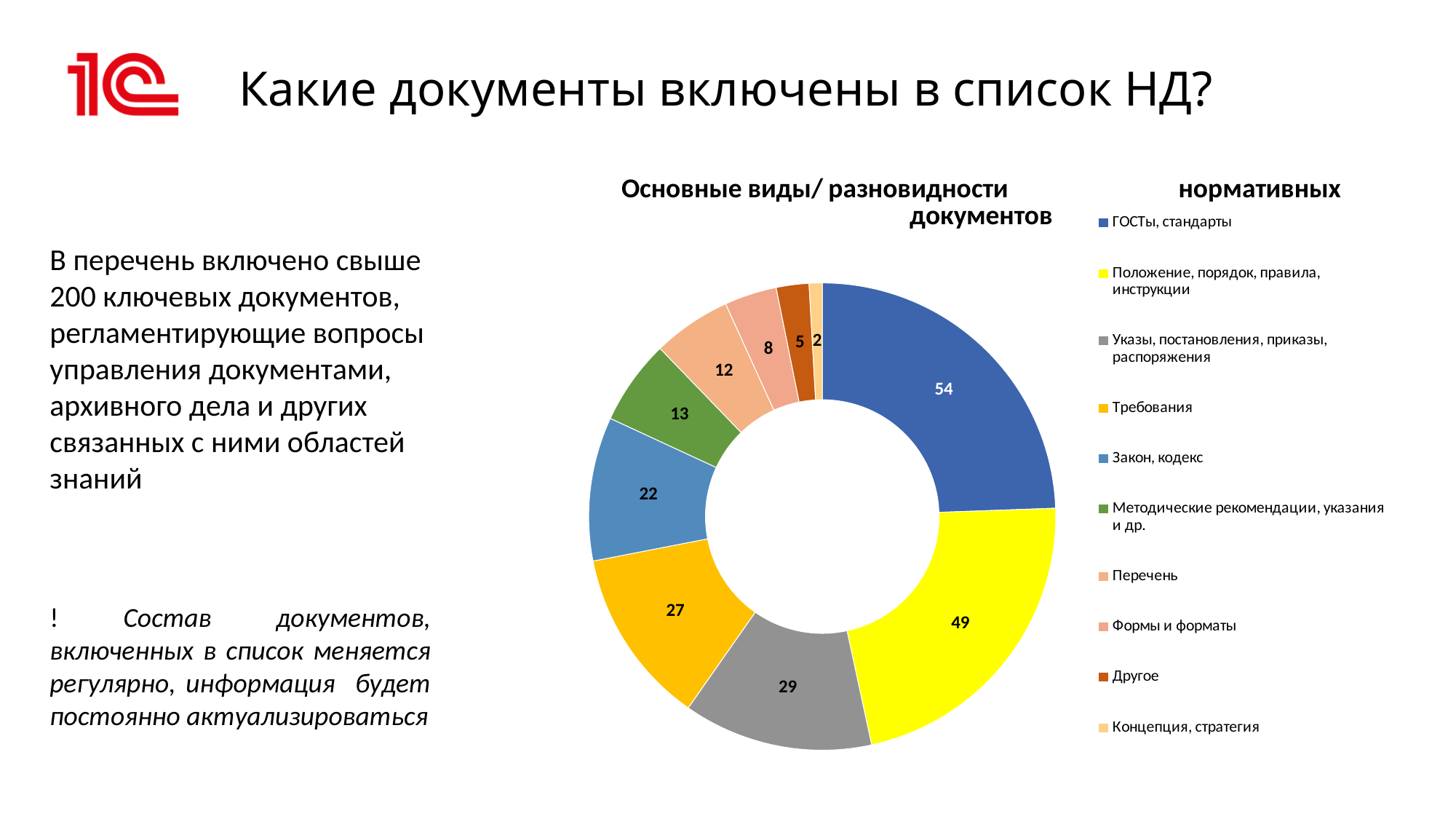
What colour is the segment for Требования in the chart? orange What is the value for Концепция, стратегия in the chart? 2 What is the value for Закон, кодекс in the chart? 22 Which category has the largest value in the chart? ГОСТы, стандарты Which category has the smallest value in the chart? Концепция, стратегия What kind of chart is shown on the slide? doughnut chart How many categories are shown in the chart? 10 What is the value for Формы и форматы in the chart? 8 What is the difference between the values for Требования and Закон, кодекс? 5 What is the difference between the values for ГОСТы, стандарты and Положение, порядок, правила, инструкции? 5 What is the value for ГОСТы, стандарты in the doughnut chart? 54 Which is larger: the value for Указы, постановления, приказы, распоряжения or the value for Методические рекомендации, указания и др.? Указы, постановления, приказы, распоряжения